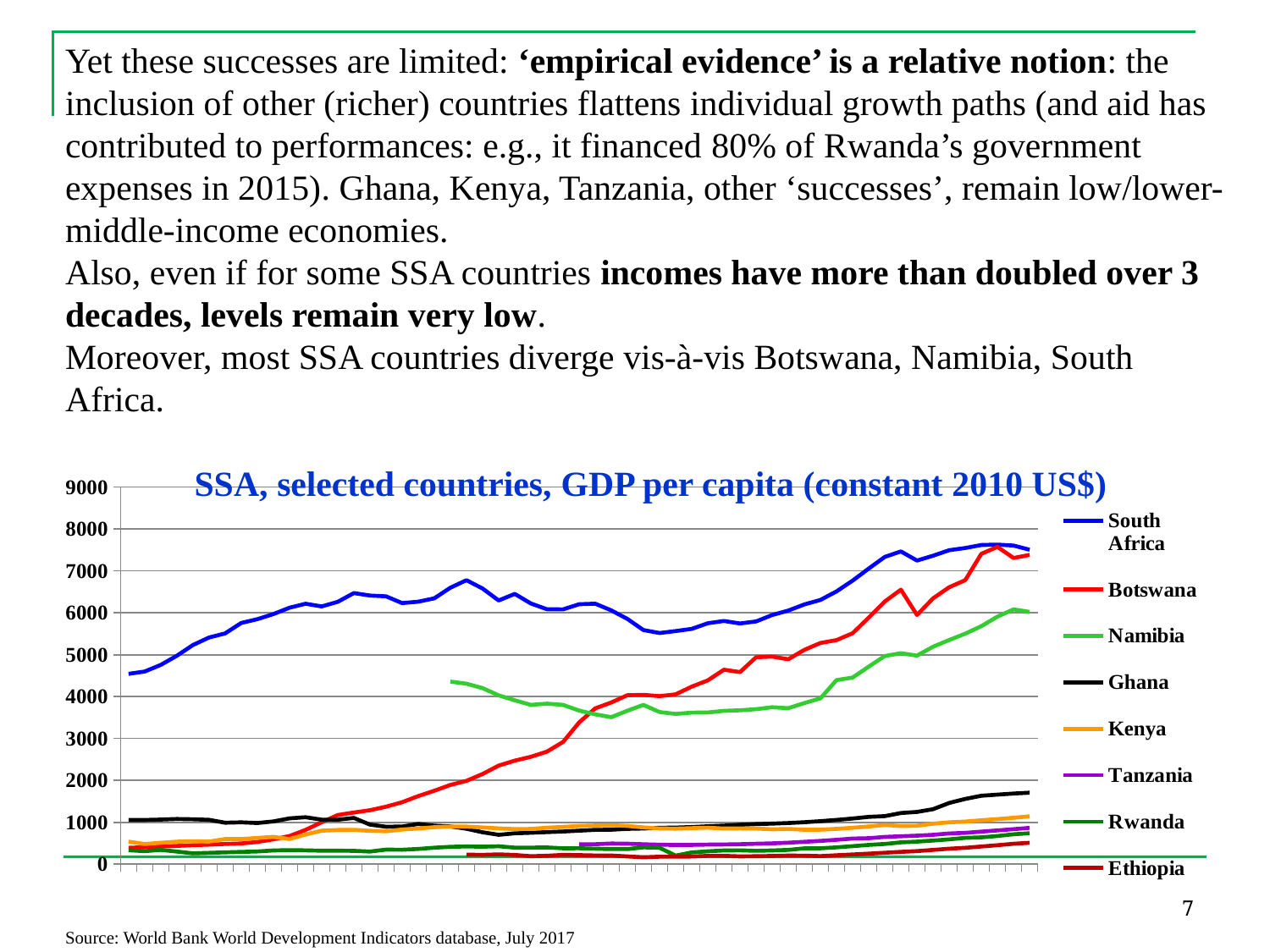
Is the value for South Africa at the right end of the chart greater or less than 7000? greater At the right end of the chart, which is larger, the value for Ghana or the value for Kenya? Ghana Is the value for Ghana at the right end of the chart greater or less than 1000? greater How many series does the legend of the chart list? 8 Is the value for Botswana at the left end of the chart greater or less than 1000? less What is the title of the chart? SSA, selected countries, GDP per capita (constant 2010 US$) Does the Botswana line rise or fall along the x axis? rise Which colour is used for the South Africa line? blue Which series has the lowest value at the right end of the chart? Ethiopia What kind of chart is shown on the slide? line chart